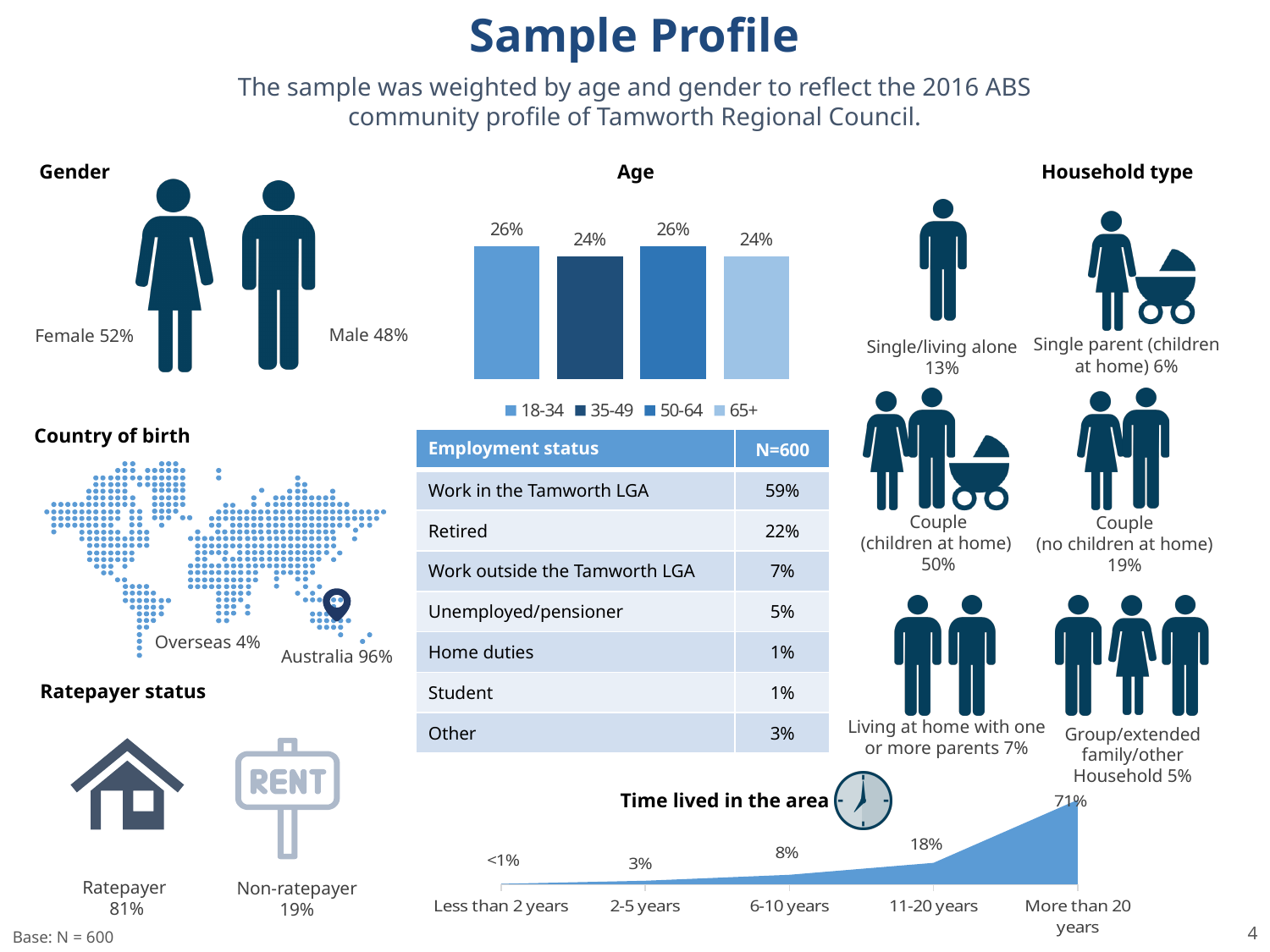
In the Time lived in the area chart, do the values rise or fall from left to right along the x axis? Rise What kind of chart is the Age chart? Bar chart In the Age chart, what is the difference between the 50-64 and 35-49 percentages? 2% In the Time lived in the area chart, what is the value for 11-20 years? 18% In the Age chart, what percentage of the sample is aged 65+? 24% How many categories are shown on the x axis of the Time lived in the area chart? 5 In the Time lived in the area chart, which category has the highest value? More than 20 years In the Time lived in the area chart, what is the value for More than 20 years? 71% In the Age chart, what percentage of the sample is aged 18-34? 26% In the Time lived in the area chart, which category has the lowest value? Less than 2 years How many entries does the legend of the Age chart list? 4 In the Age chart, which is larger: the 18-34 value or the 35-49 value? 18-34